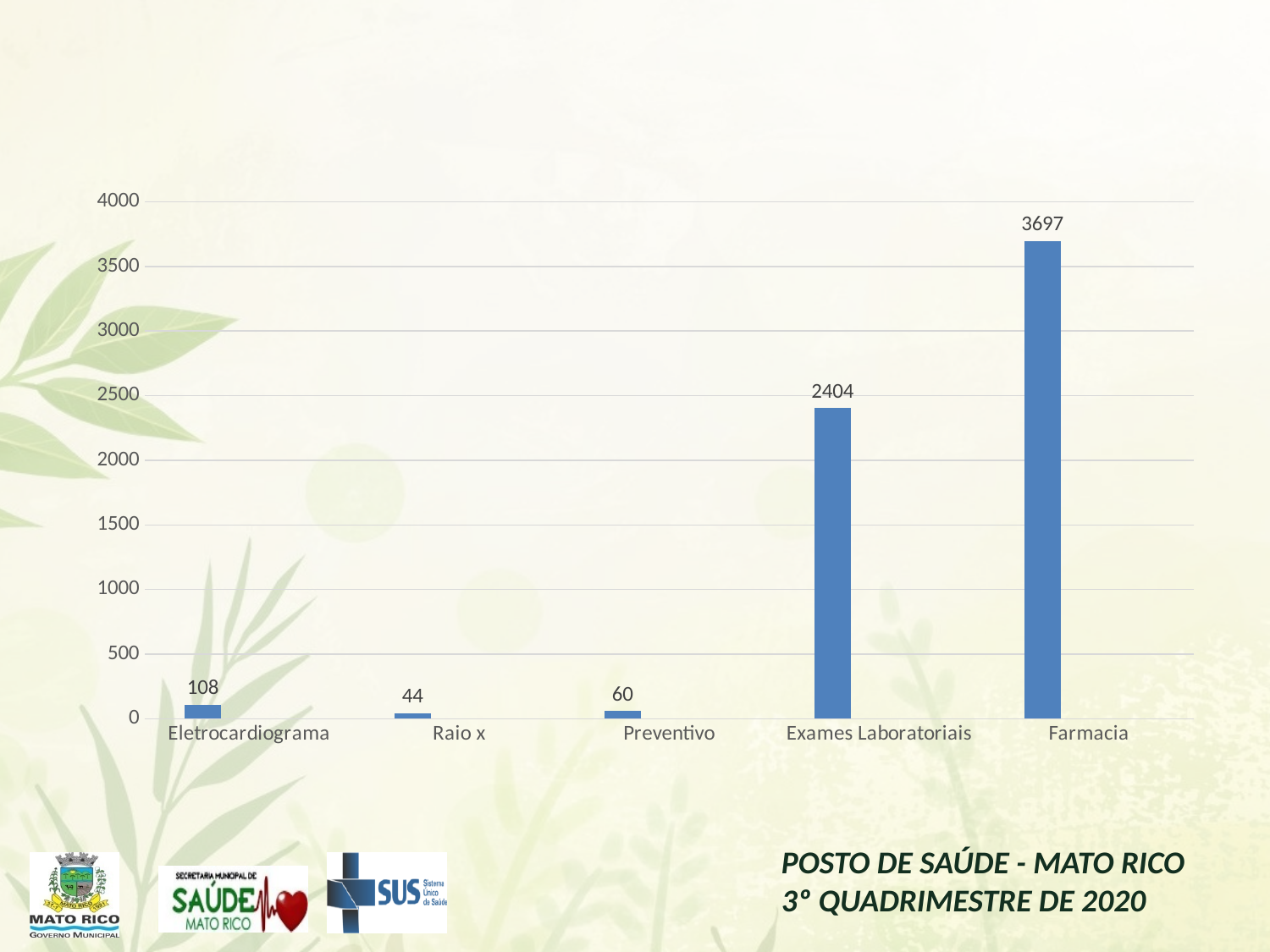
What kind of chart is shown on the slide? bar chart What is the difference between the values for Farmacia and Exames Laboratoriais? 1293 What is the value for Preventivo? 60 What is the value for Farmacia? 3697 What is the value for Raio x? 44 Which category has the highest value? Farmacia How many categories are shown on the x axis? 5 Is the value for Exames Laboratoriais greater or less than 2000? greater What is the value for Eletrocardiograma? 108 What is the value for Exames Laboratoriais? 2404 Which is larger, the value for Eletrocardiograma or the value for Preventivo? Eletrocardiograma Which category has the lowest value? Raio x